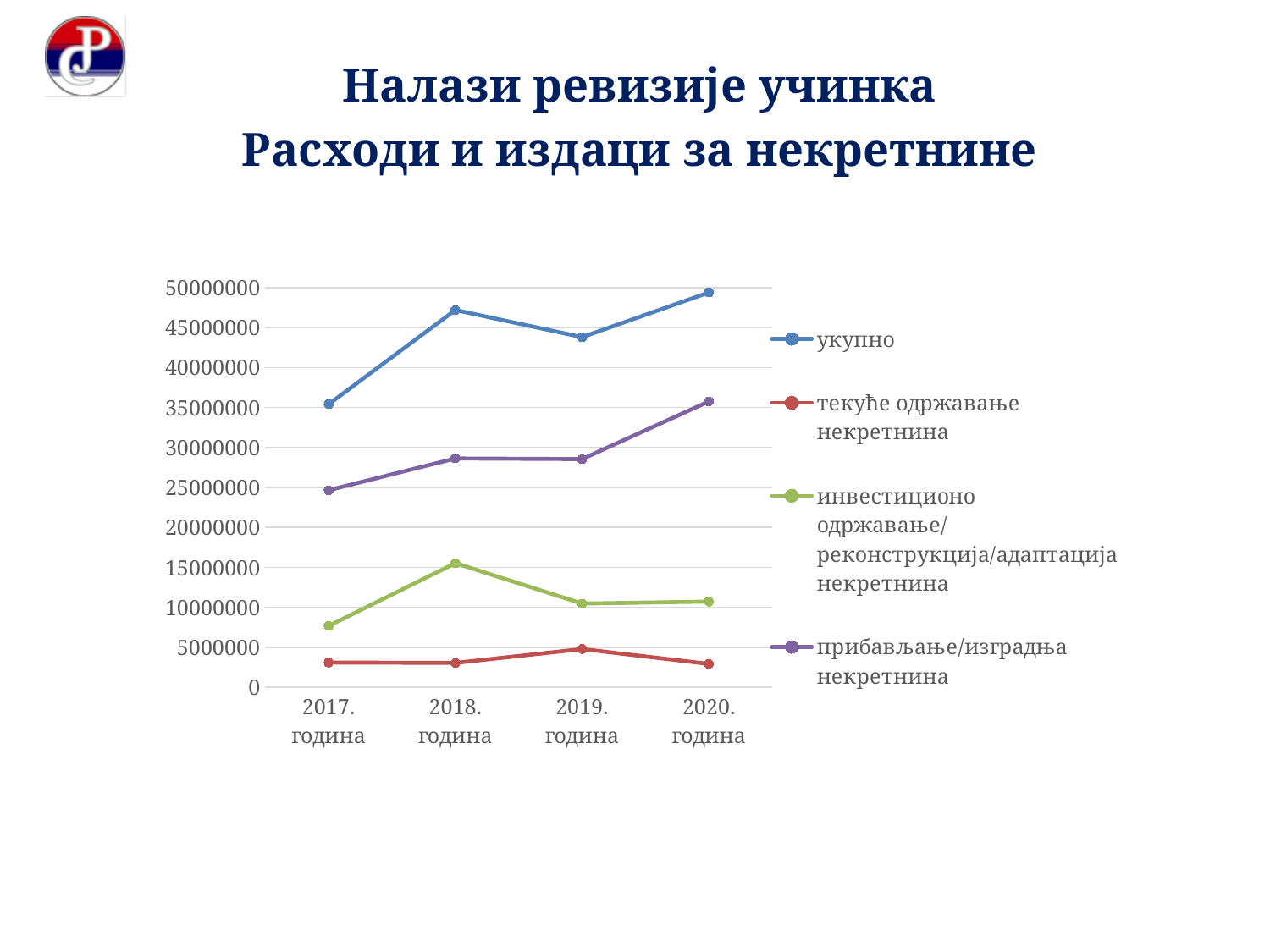
In which year is the value for инвестиционо одржавање/реконструкција/адаптација некретнина highest? 2018. година Which year has the larger value for укупно, 2018. година or 2019. година? 2018. година How many series does the legend list? 4 What kind of chart is shown on the slide? line chart Is the value for инвестиционо одржавање/реконструкција/адаптација некретнина in 2018. година greater or less than 10000000? greater In which year is the value for укупно lowest? 2017. година Does the value for прибављање/изградња некретнина rise or fall from 2019. година to 2020. година? rise Is the value for укупно in 2017. година greater or less than 40000000? less In which year is the value for укупно highest? 2020. година Is the value for прибављање/изградња некретнина in 2020. година greater or less than 30000000? greater In which year is the value for текуће одржавање некретнина highest? 2019. година How many years are shown on the x axis? 4